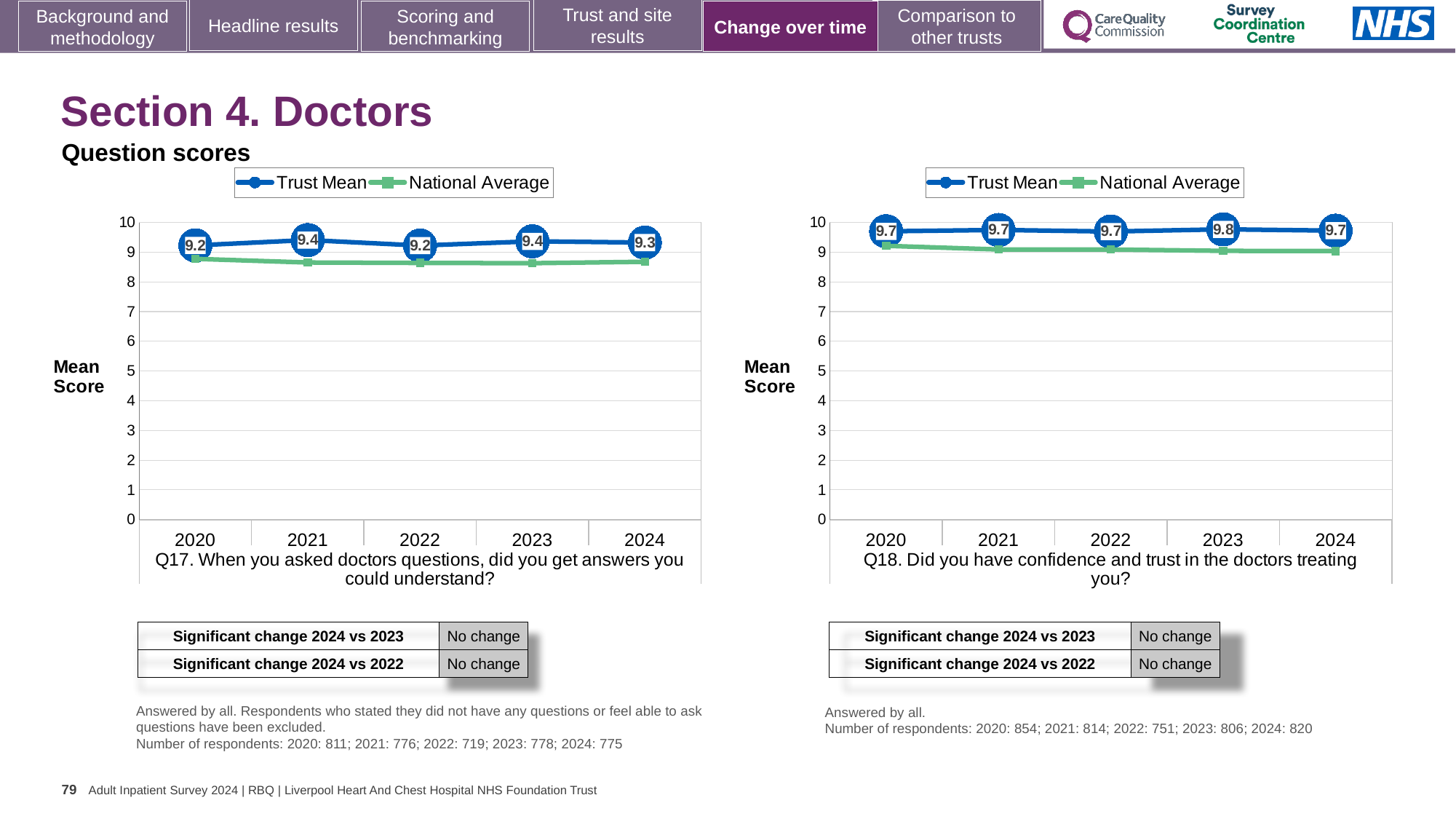
What kind of chart is the Q18 chart (right)? Line chart In the Q18 chart (right), is the National Average value for 2024 greater or less than 8? greater In the Q17 chart (left), what is the Trust Mean score for 2021? 9.4 What are the two series named in the legend of the Q18 chart (right)? Trust Mean and National Average In the Q17 chart (left), which is larger, the Trust Mean score for 2023 or for 2024? 2023 In the Q17 chart (left), what is the Trust Mean score for 2024? 9.3 In the Q18 chart (right), what is the Trust Mean score for 2023? 9.8 In the Q17 chart (left), what is the difference between the Trust Mean scores for 2021 and 2020? 0.2 In the Q17 chart (left), is the National Average value for 2024 greater or less than 9? less How many years are shown on the x axis of the Q18 chart (right)? 5 In the Q18 chart (right), which year has the highest Trust Mean score? 2023 How many series does the legend of the Q17 chart (left) list? 2